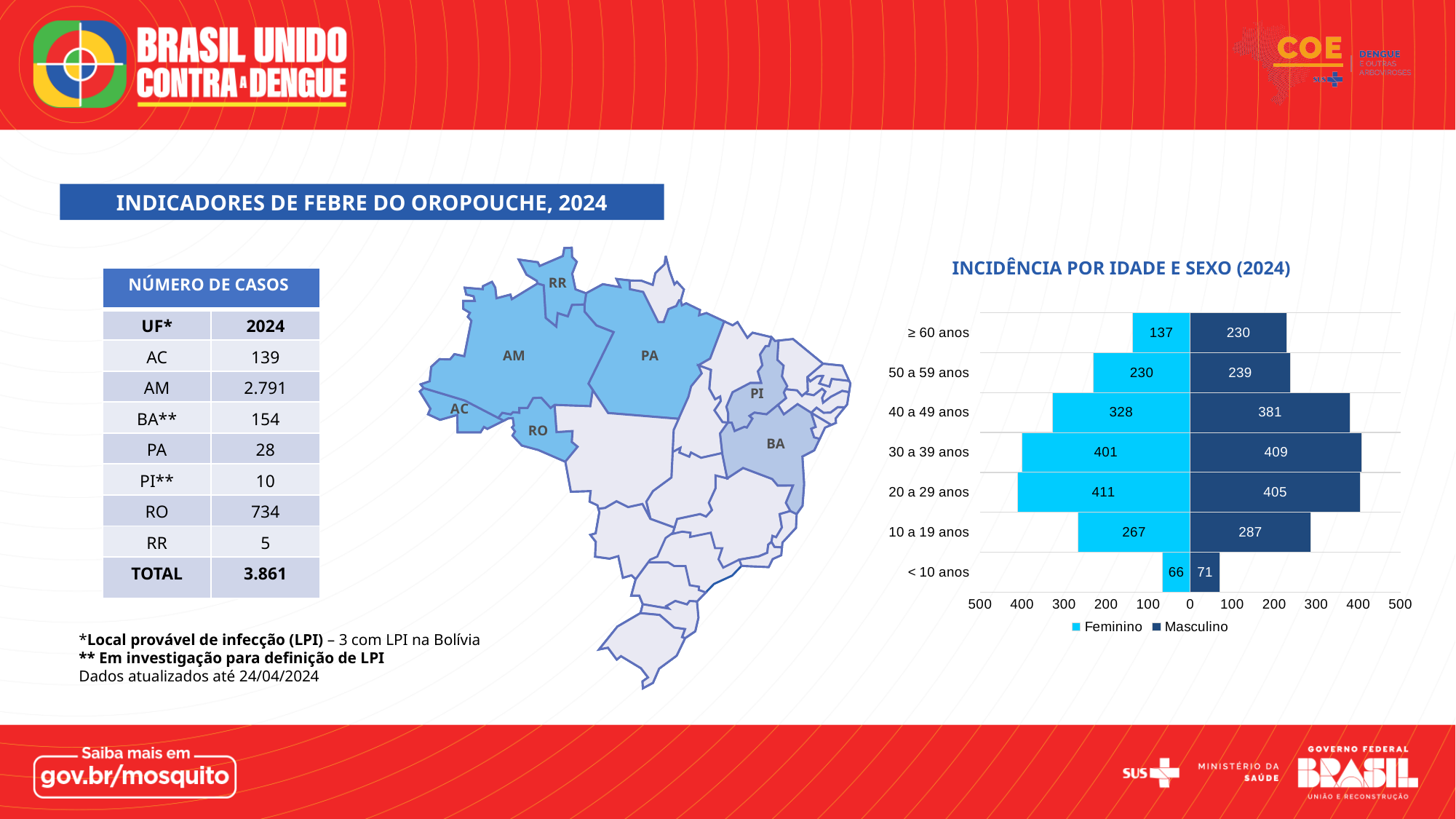
In the chart 'INCIDÊNCIA POR IDADE E SEXO (2024)', what is the Feminino value for 40 a 49 anos? 328 In the chart 'INCIDÊNCIA POR IDADE E SEXO (2024)', what is the difference between the Masculino and Feminino values for 30 a 39 anos? 8 How many series does the legend of the chart 'INCIDÊNCIA POR IDADE E SEXO (2024)' list? 2 How many age groups are shown in the chart 'INCIDÊNCIA POR IDADE E SEXO (2024)'? 7 In the chart 'INCIDÊNCIA POR IDADE E SEXO (2024)', what is the difference between the Masculino and Feminino values for ≥ 60 anos? 93 In the chart 'INCIDÊNCIA POR IDADE E SEXO (2024)', what is the Masculino value for ≥ 60 anos? 230 In the chart 'INCIDÊNCIA POR IDADE E SEXO (2024)', what is the Feminino value for < 10 anos? 66 In the chart 'INCIDÊNCIA POR IDADE E SEXO (2024)', for 20 a 29 anos, which is larger: Feminino or Masculino? Feminino In the chart 'INCIDÊNCIA POR IDADE E SEXO (2024)', which age group has the highest Feminino value? 20 a 29 anos In the chart 'INCIDÊNCIA POR IDADE E SEXO (2024)', which age group has the lowest Masculino value? < 10 anos What kind of chart is 'INCIDÊNCIA POR IDADE E SEXO (2024)'? bar chart In the chart 'INCIDÊNCIA POR IDADE E SEXO (2024)', what is the combined Feminino and Masculino value for 10 a 19 anos? 554